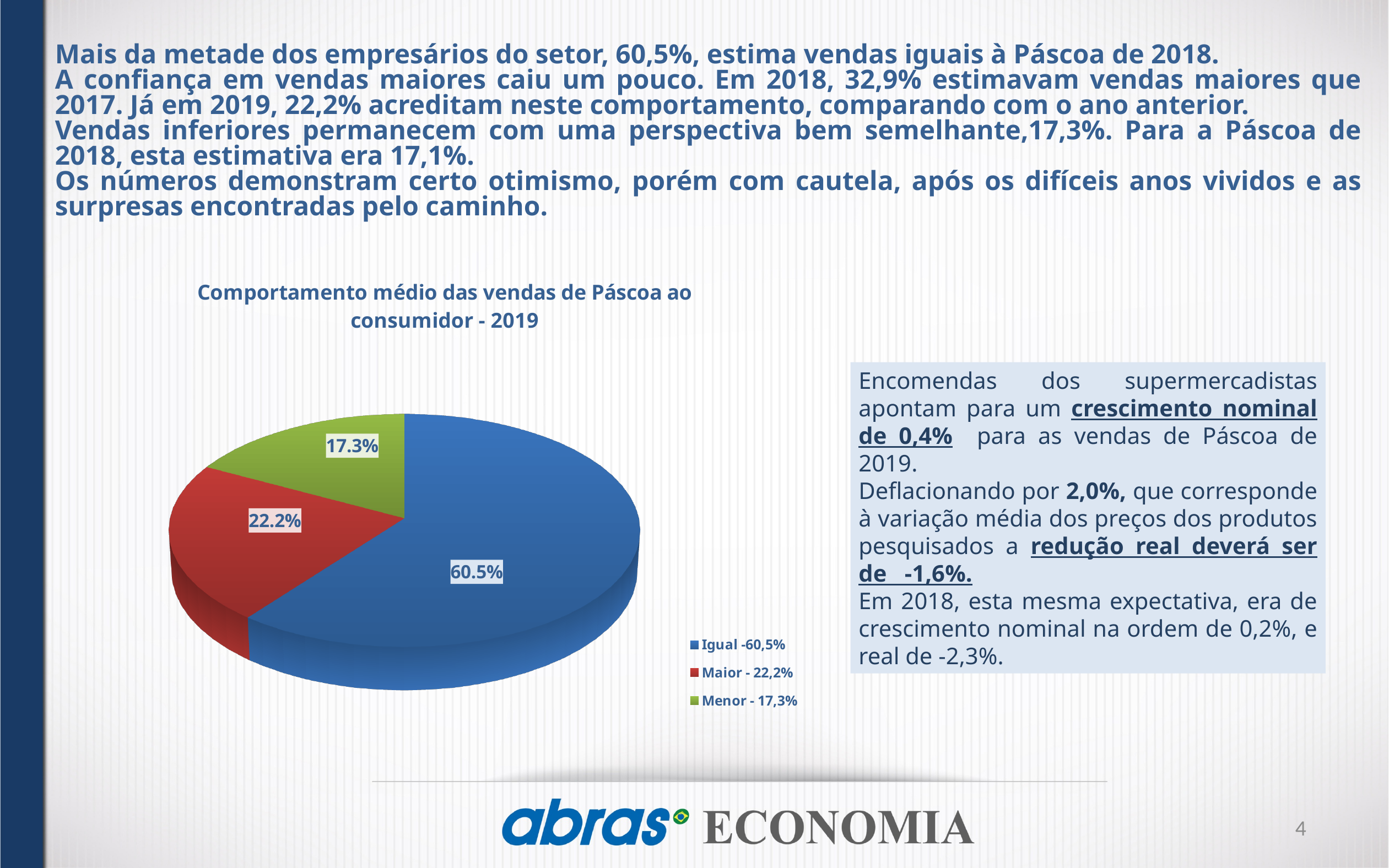
Which slice of the pie chart is the largest? Igual What is the difference between the 'Maior' slice and the 'Menor' slice? 4.9% What kind of chart is shown on the slide? pie chart How many slices does the pie chart have? 3 What is the difference between the 'Igual' slice and the 'Maior' slice? 38.3% What is the title of the chart? Comportamento médio das vendas de Páscoa ao consumidor - 2019 What is the value shown for the 'Igual' slice? 60.5% What colour is the 'Menor' slice in the pie chart? green What is the value shown for the 'Maior' slice? 22.2% Which is larger, the 'Maior' slice or the 'Menor' slice? Maior Which slice of the pie chart is the smallest? Menor What is the value shown for the 'Menor' slice? 17.3%